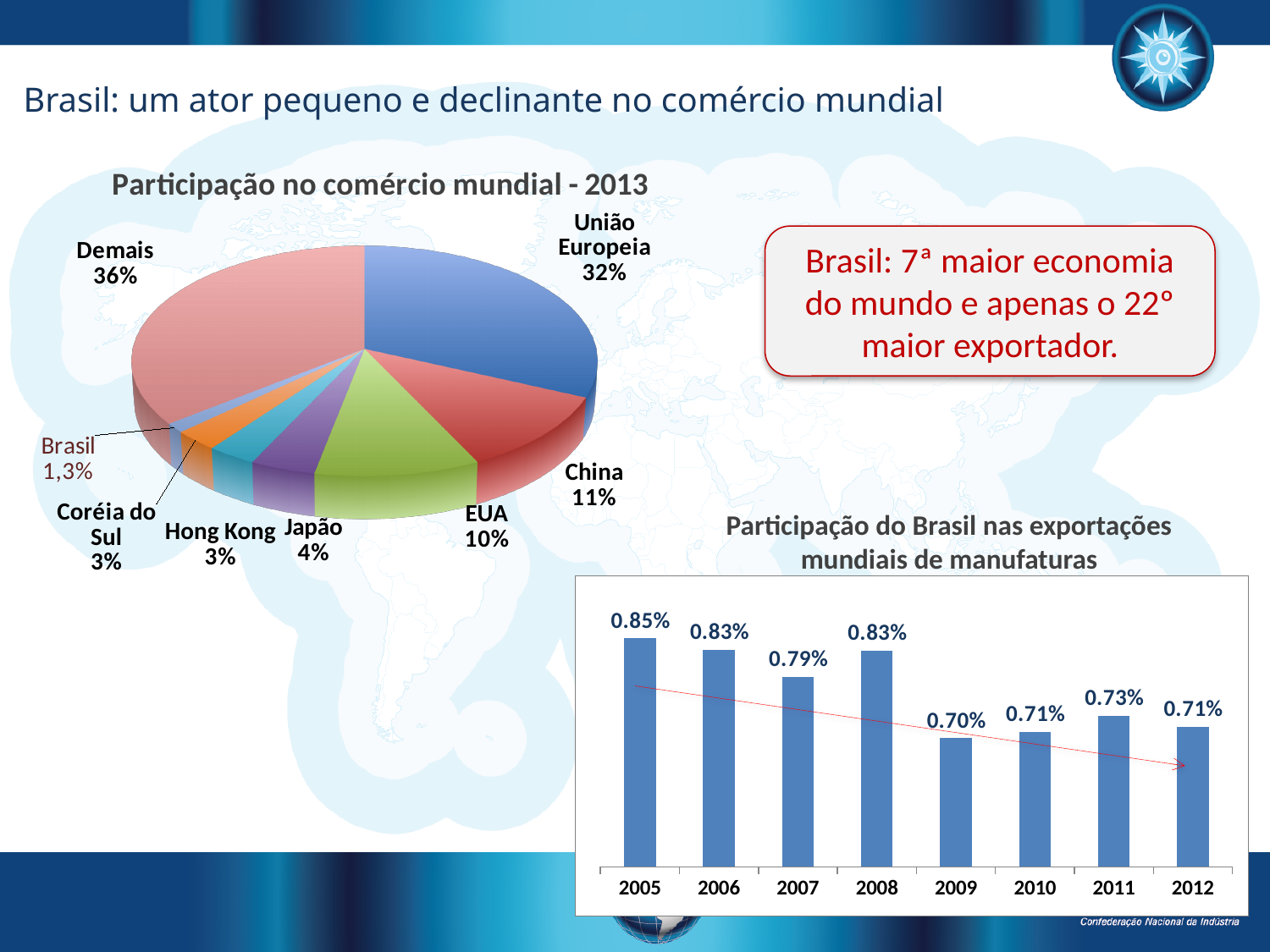
In the bar chart 'Participação do Brasil nas exportações mundiais de manufaturas', what is the value for 2007? 0.79% What kind of chart is 'Participação no comércio mundial - 2013'? Pie chart In the pie chart 'Participação no comércio mundial - 2013', which labelled slice is the smallest? Brasil In the pie chart 'Participação no comércio mundial - 2013', which labelled slice is the largest? Demais In the bar chart 'Participação do Brasil nas exportações mundiais de manufaturas', which year has the highest value? 2005 In the bar chart 'Participação do Brasil nas exportações mundiais de manufaturas', which year has the lowest value? 2009 In the bar chart 'Participação do Brasil nas exportações mundiais de manufaturas', do the values generally rise or fall from 2005 to 2012? Fall In the pie chart 'Participação no comércio mundial - 2013', what share does União Europeia have? 32% In the pie chart 'Participação no comércio mundial - 2013', what share does Brasil have? 1,3% In the pie chart 'Participação no comércio mundial - 2013', which is larger, China or EUA? China In the bar chart 'Participação do Brasil nas exportações mundiais de manufaturas', what is the difference between the 2005 and 2012 values? 0.14% In the pie chart 'Participação no comércio mundial - 2013', how many slices are labelled? 8